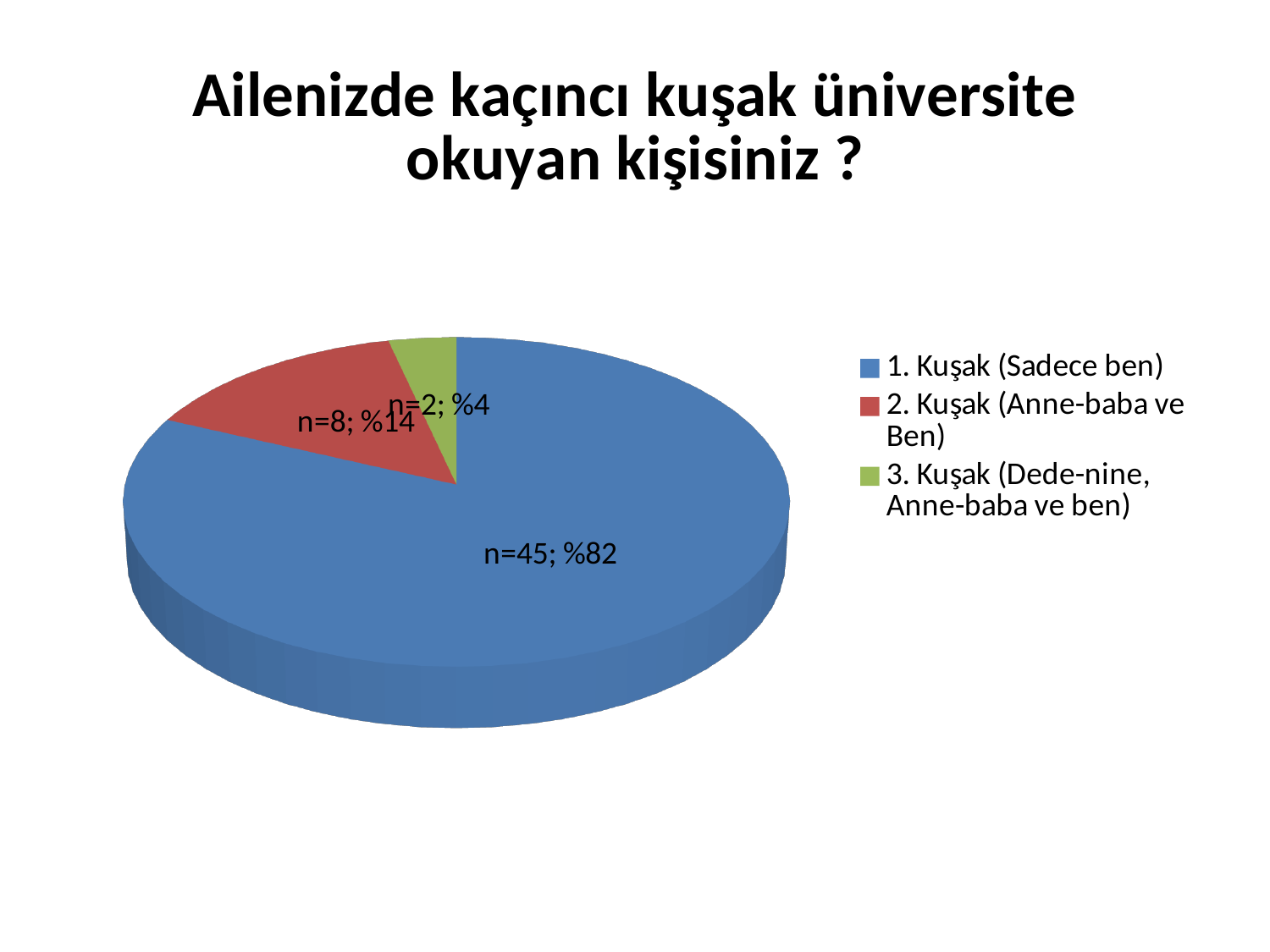
What is the count (n) for 1. Kuşak (Sadece ben)? n=45 What percentage share does 2. Kuşak (Anne-baba ve Ben) have? %14 Which category has the largest slice? 1. Kuşak (Sadece ben) How many entries does the legend list? 3 Which category has the smallest slice? 3. Kuşak (Dede-nine, Anne-baba ve ben) What colour is the slice for 3. Kuşak (Dede-nine, Anne-baba ve ben)? green What percentage share does 1. Kuşak (Sadece ben) have? %82 What is the difference in count between 1. Kuşak (Sadece ben) and 2. Kuşak (Anne-baba ve Ben)? 37 How many slices does the pie chart have? 3 What is the count (n) for 3. Kuşak (Dede-nine, Anne-baba ve ben)? n=2 What is the count (n) for 2. Kuşak (Anne-baba ve Ben)? n=8 What kind of chart is shown on the slide? pie chart